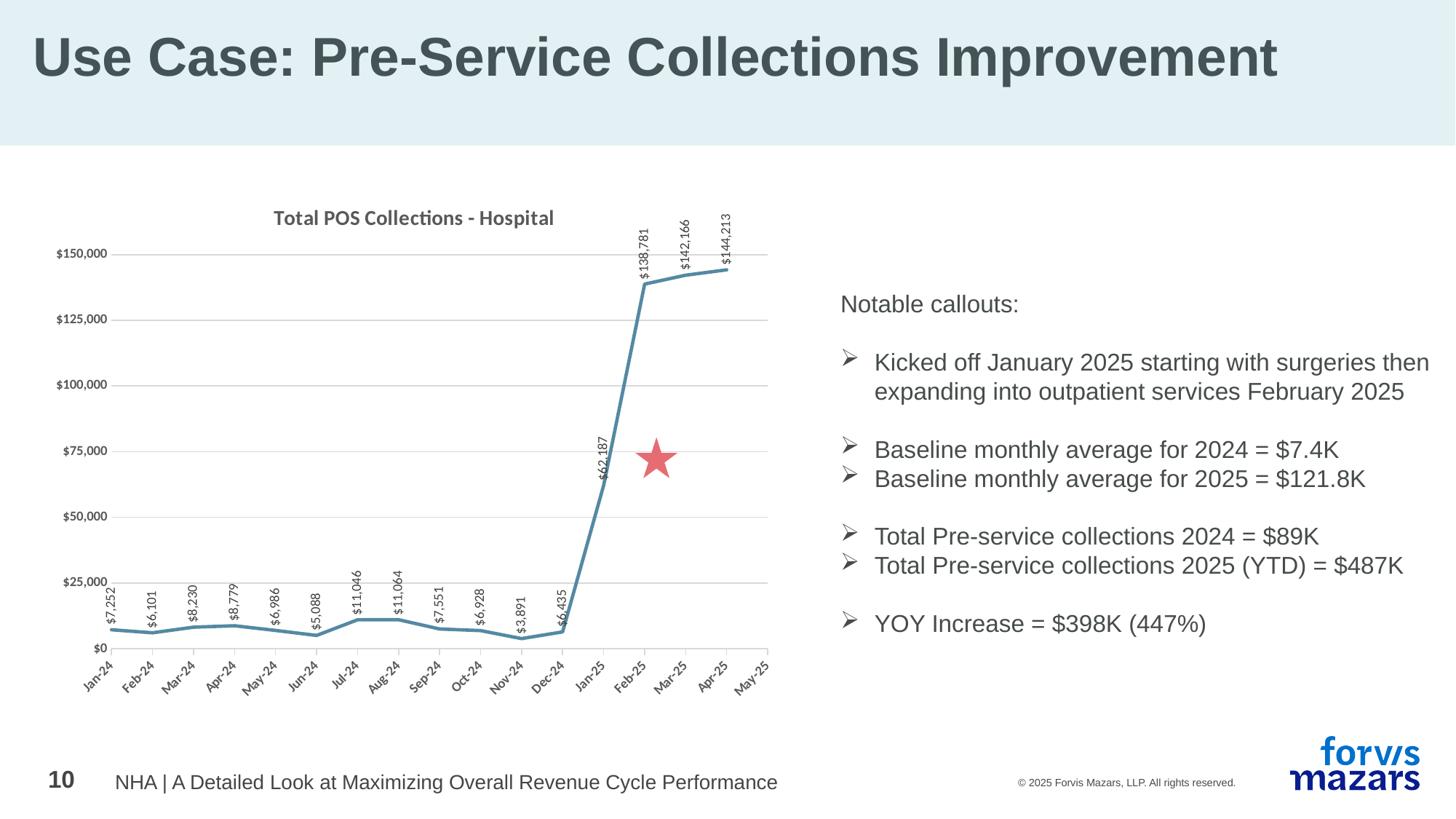
What is the value for Nov-24 in the Total POS Collections - Hospital chart? $3,891 What is the difference between the Feb-25 and Jan-25 values in the Total POS Collections - Hospital chart? $76,594 Which is larger in the Total POS Collections - Hospital chart, the value for Mar-24 or the value for Jun-24? Mar-24 What is the value for Apr-25 in the Total POS Collections - Hospital chart? $144,213 What is the value for Jan-25 in the Total POS Collections - Hospital chart? $62,187 What kind of chart is the Total POS Collections - Hospital chart? line chart Do the values in the Total POS Collections - Hospital chart rise or fall from Dec-24 to Apr-25? rise Which month has the highest value in the Total POS Collections - Hospital chart? Apr-25 Which month has the lowest value in the Total POS Collections - Hospital chart? Nov-24 What is the title of the chart on the slide? Total POS Collections - Hospital What is the difference between the Apr-25 and Jan-24 values in the Total POS Collections - Hospital chart? $136,961 Is the value for Jan-25 in the Total POS Collections - Hospital chart greater or less than $50,000? greater